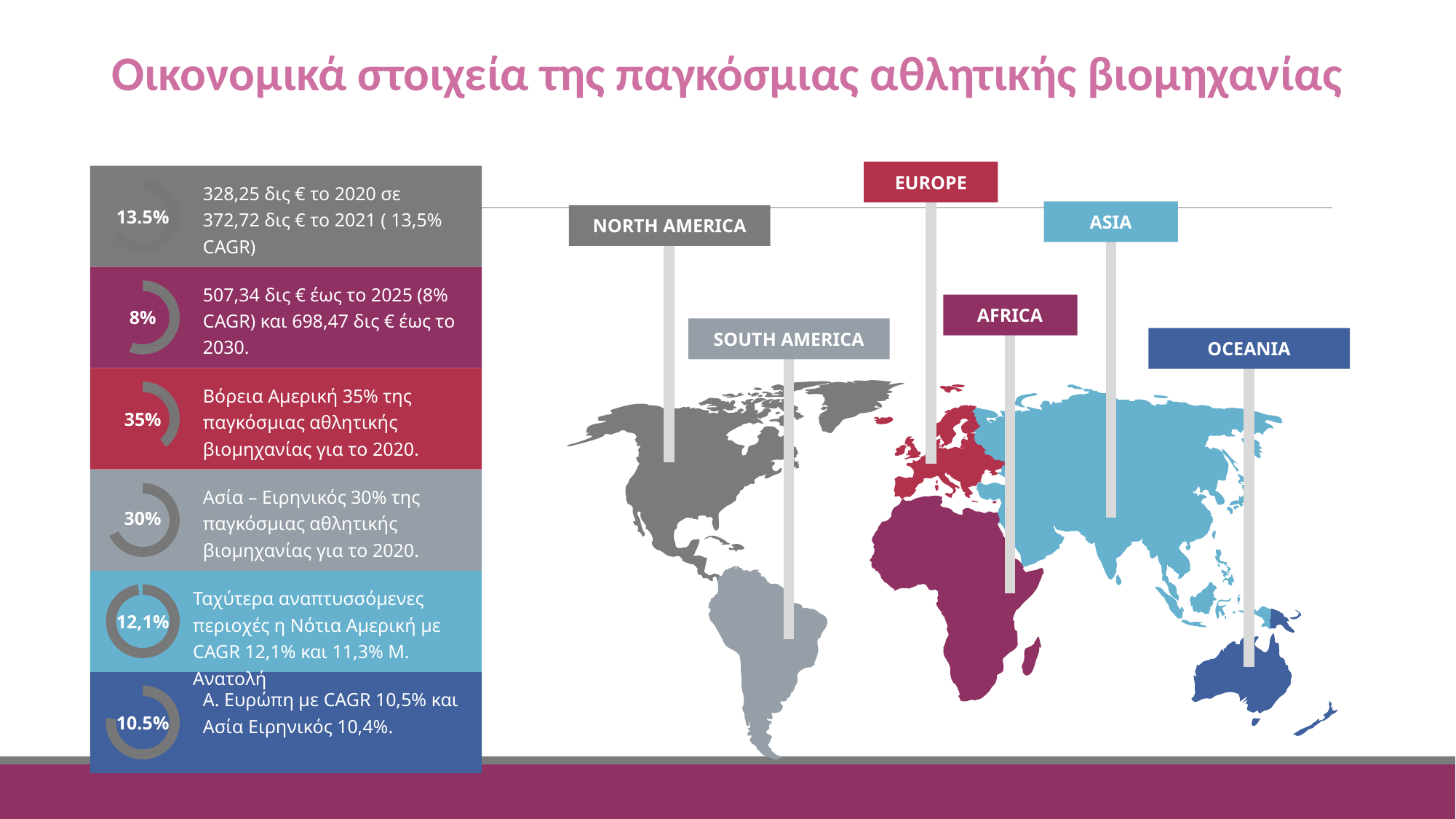
What is the difference between the North America share (35%) and the Asia-Pacific share (30%) shown in the rings? 5% What percentage is shown in the ring for Ασία – Ειρηνικός (Asia-Pacific) share of the global sports industry for 2020? 30% What percentage is shown in the first (top, grey) ring on the left panel? 13.5% What percentage is shown in the light-blue ring about the fastest-growing regions (Νότια Αμερική)? 12,1% Which is larger: the ring value for Βόρεια Αμερική (35%) or the ring value for Ασία – Ειρηνικός (30%)? Βόρεια Αμερική (35%) What percentage is shown in the bottom (dark blue) ring on the left panel? 10.5% How many continent labels are shown on the world map? 6 Which ring on the left panel shows the lowest percentage? 8% What percentage is shown in the ring next to the text about 507,34 δις € έως το 2025? 8% Which ring on the left panel shows the highest percentage? 35% How many percentage rings are shown on the left panel? 6 What percentage is shown in the ring for Βόρεια Αμερική (North America) share of the global sports industry for 2020? 35%